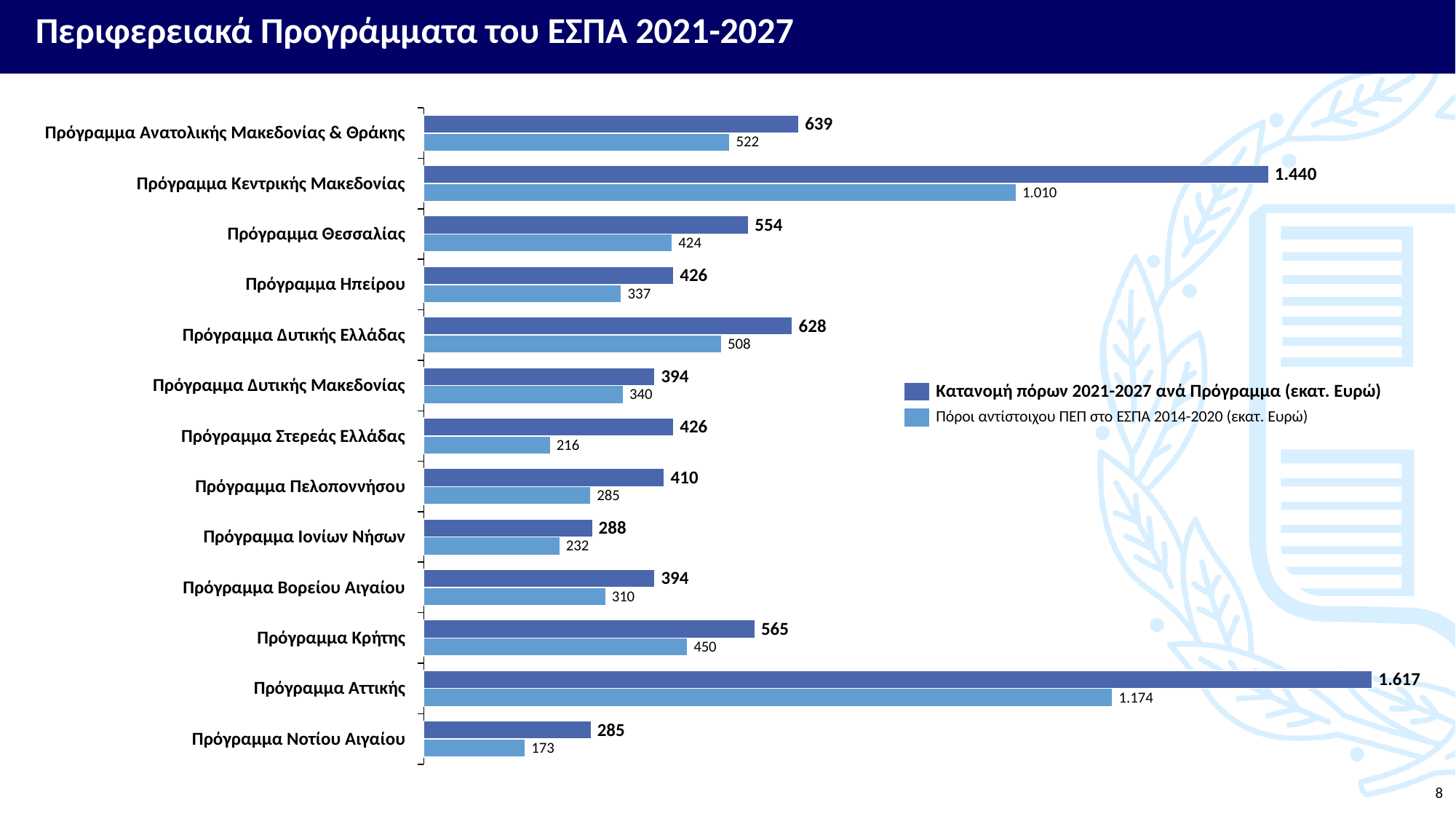
How many programmes (categories) are shown in the chart? 13 Which programme has the highest value in the series Κατανομή πόρων 2021-2027 ανά Πρόγραμμα? Πρόγραμμα Αττικής What is the difference between the 2021-2027 value and the 2014-2020 value for Πρόγραμμα Στερεάς Ελλάδας? 210 Which programme has the lowest value in the series Πόροι αντίστοιχου ΠΕΠ στο ΕΣΠΑ 2014-2020? Πρόγραμμα Νοτίου Αιγαίου What is the title of the slide? Περιφερειακά Προγράμματα του ΕΣΠΑ 2021-2027 What is the difference between the 2021-2027 value and the 2014-2020 value for Πρόγραμμα Αττικής? 443 How many series does the legend list? 2 What is the value for Πρόγραμμα Κρήτης in the series Κατανομή πόρων 2021-2027 ανά Πρόγραμμα (εκατ. Ευρώ)? 565 What is the 2021-2027 value for Πρόγραμμα Κεντρικής Μακεδονίας? 1.440 Which has the larger 2021-2027 value: Πρόγραμμα Δυτικής Ελλάδας or Πρόγραμμα Ηπείρου? Πρόγραμμα Δυτικής Ελλάδας What is the value for Πρόγραμμα Ηπείρου in the series Πόροι αντίστοιχου ΠΕΠ στο ΕΣΠΑ 2014-2020 (εκατ. Ευρώ)? 337 What kind of chart is shown on the slide? Bar chart